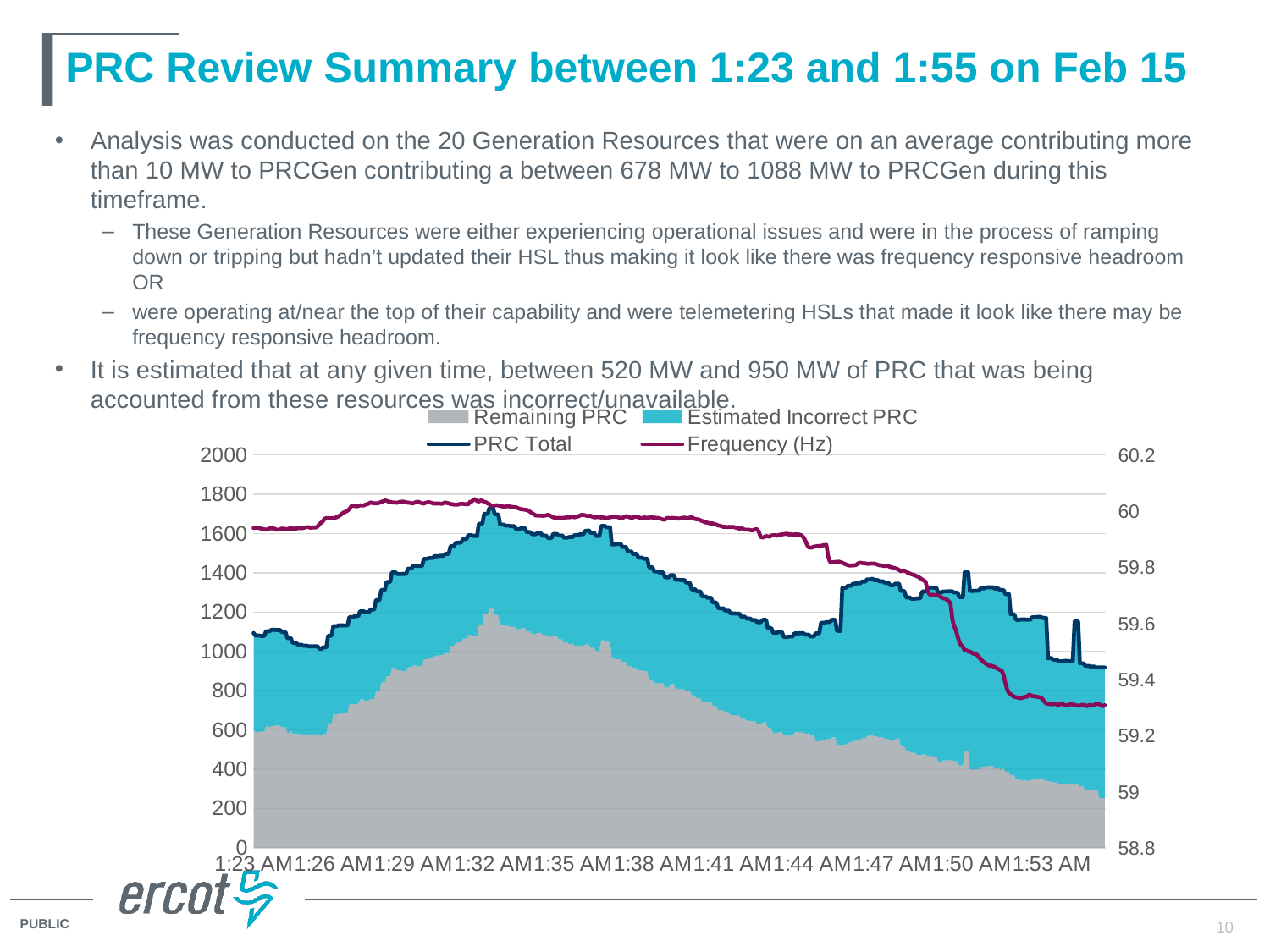
Is the PRC Total value at 1:23 AM greater or less than 1000? greater Is the Remaining PRC value at 1:53 AM greater or less than 400? less Is the PRC Total value at 1:53 AM greater or less than 1000? less How many series does the chart legend list? 4 What is the maximum value shown on the right-hand (secondary) vertical axis? 60.2 Does the Frequency (Hz) line rise or fall overall from 1:23 AM to 1:53 AM? Fall Which is larger at 1:53 AM, the PRC Total or the Remaining PRC? PRC Total What kind of chart is shown on the slide? Combined stacked area and line chart Which series is plotted against the right-hand (secondary) vertical axis? Frequency (Hz)